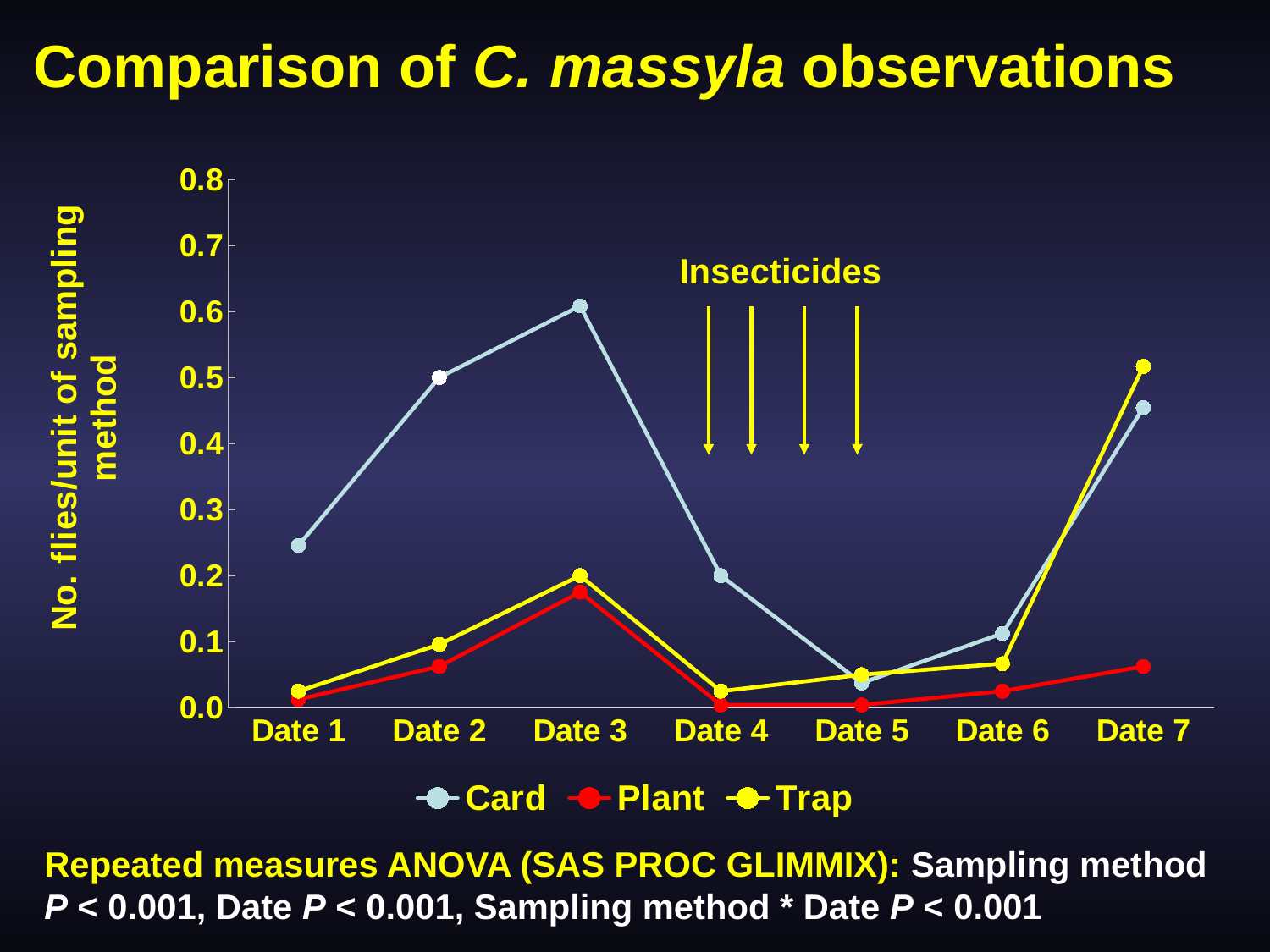
Is the value for Trap at Date 7 greater or less than 0.4? greater On which date does the Card series reach its lowest value? Date 5 On which date does the Trap series reach its highest value? Date 7 What label is written above the four arrows on the chart? Insecticides On which date does the Card series reach its highest value? Date 3 What kind of chart is shown on the slide? line chart At Date 2, which series has the larger value, Card or Trap? Card Is the value for Plant at Date 4 greater or less than 0.1? less How many series does the legend list? 3 How many dates are shown along the x axis? 7 Is the value for Card at Date 3 greater or less than 0.5? greater Does the Card series rise or fall from Date 3 to Date 5? fall